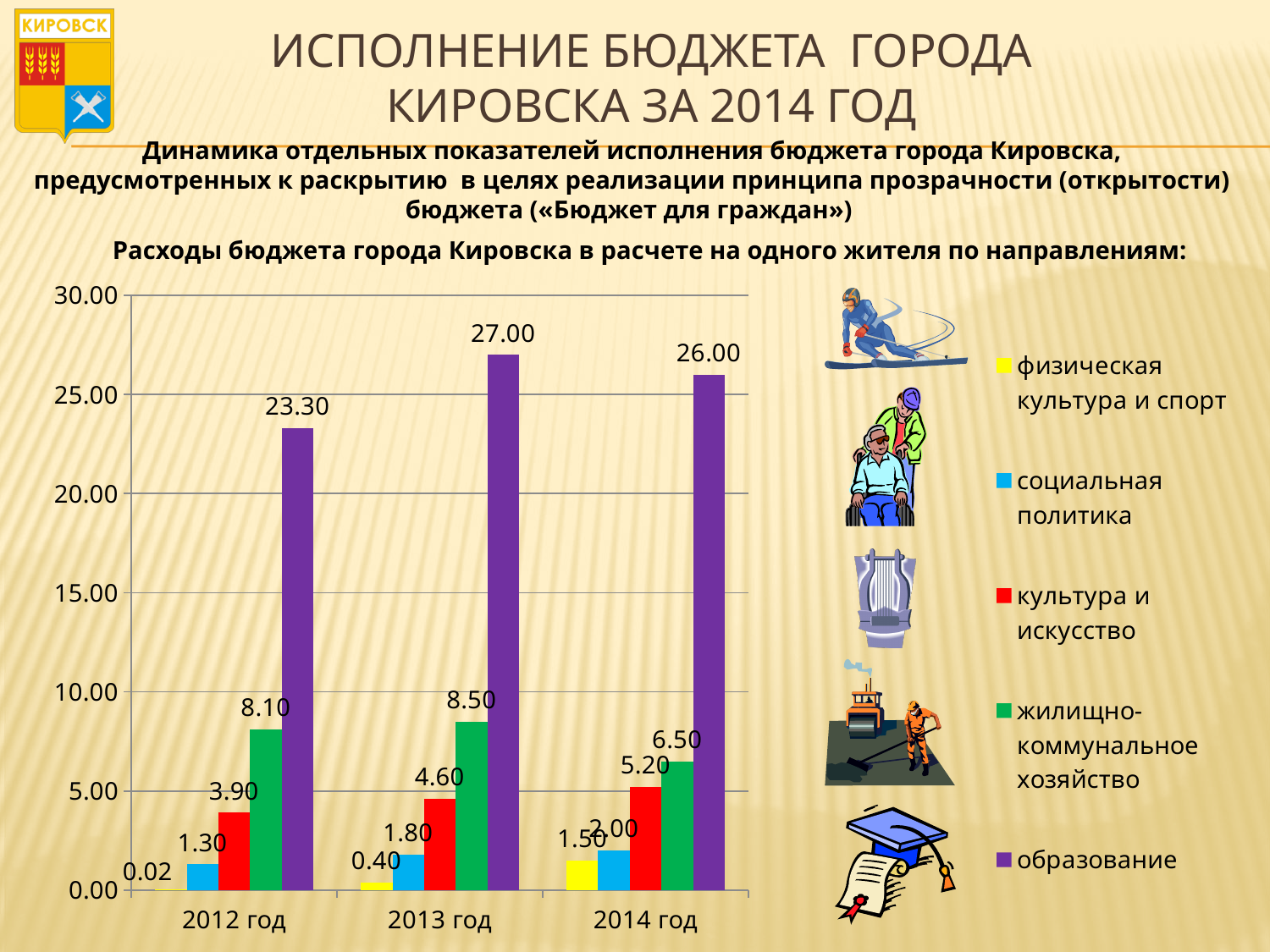
What is the value for образование in 2013 год? 27.00 What kind of chart is shown on the slide? bar chart Which is larger: социальная политика in 2013 год or социальная политика in 2014 год? 2014 год What is the value for физическая культура и спорт in 2012 год? 0.02 What is the value for жилищно-коммунальное хозяйство in 2012 год? 8.10 How many years are shown on the x axis? 3 In which year is the value for жилищно-коммунальное хозяйство lowest? 2014 год What is the difference between the образование values for 2013 год and 2012 год? 3.70 Is the value for образование in 2014 год greater or less than 25.00? greater What is the value for культура и искусство in 2014 год? 5.20 How many series does the legend list? 5 In which year is the value for образование highest? 2013 год